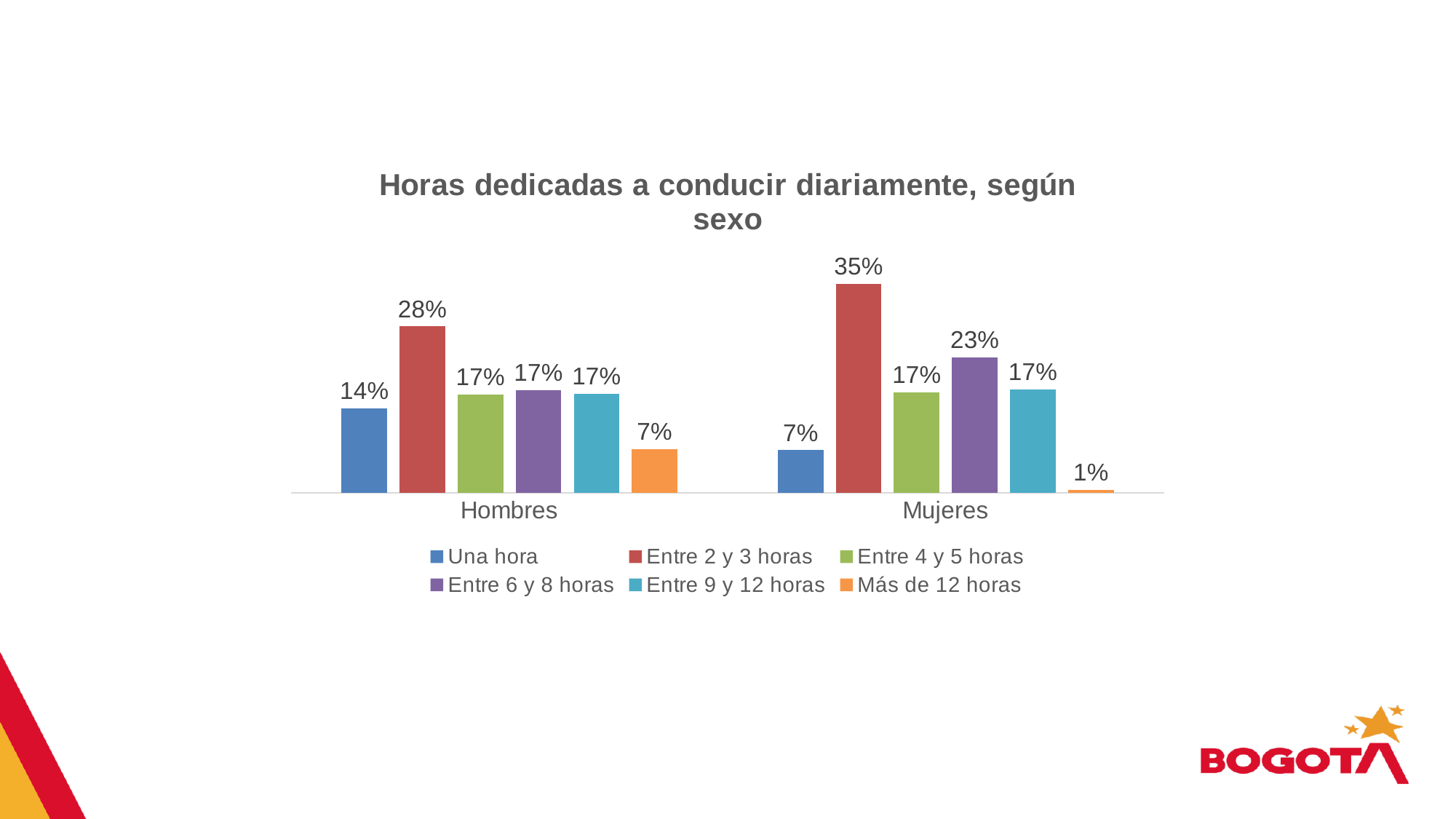
How many categories are shown on the x axis? 2 What is the value for 'Entre 2 y 3 horas' in the Hombres category? 28% Which series has the lowest value in the Mujeres category? Más de 12 horas What kind of chart is shown on the slide? Bar chart Which series has the highest value in the Mujeres category? Entre 2 y 3 horas What is the difference between the 'Entre 2 y 3 horas' values for Mujeres and Hombres? 7% What is the value for 'Una hora' in the Mujeres category? 7% What is the value for 'Entre 6 y 8 horas' in the Mujeres category? 23% Which is larger: the 'Una hora' value for Hombres or for Mujeres? Hombres What is the value for 'Más de 12 horas' in the Mujeres category? 1% What is the title of the chart? Horas dedicadas a conducir diariamente, según sexo How many series does the legend list? 6